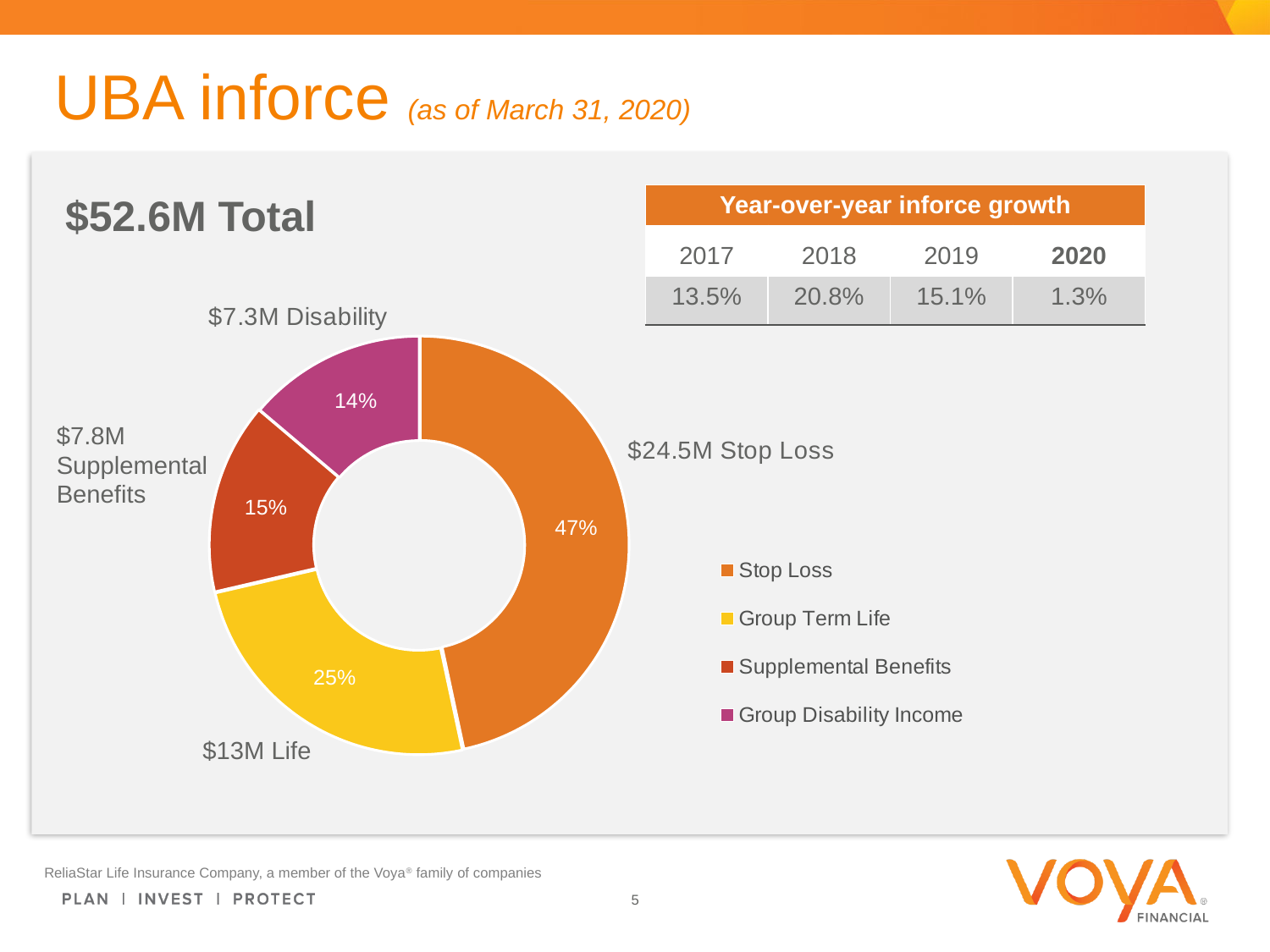
How many slices does the pie chart have? 4 What share of the pie does Stop Loss represent? 47% What is the difference in percentage points between the Stop Loss share and the Group Term Life share? 22 percentage points What kind of chart is shown on the slide? Pie chart (donut) Which slice of the pie chart is the smallest? Group Disability Income What is the dollar amount labelled for Life on the pie chart? $13M Which slice of the pie chart is the largest? Stop Loss What total amount is shown above the pie chart? $52.6M Total What share of the pie does Group Disability Income represent? 14% What share of the pie does Group Term Life represent? 25% What is the dollar amount labelled for Stop Loss on the pie chart? $24.5M